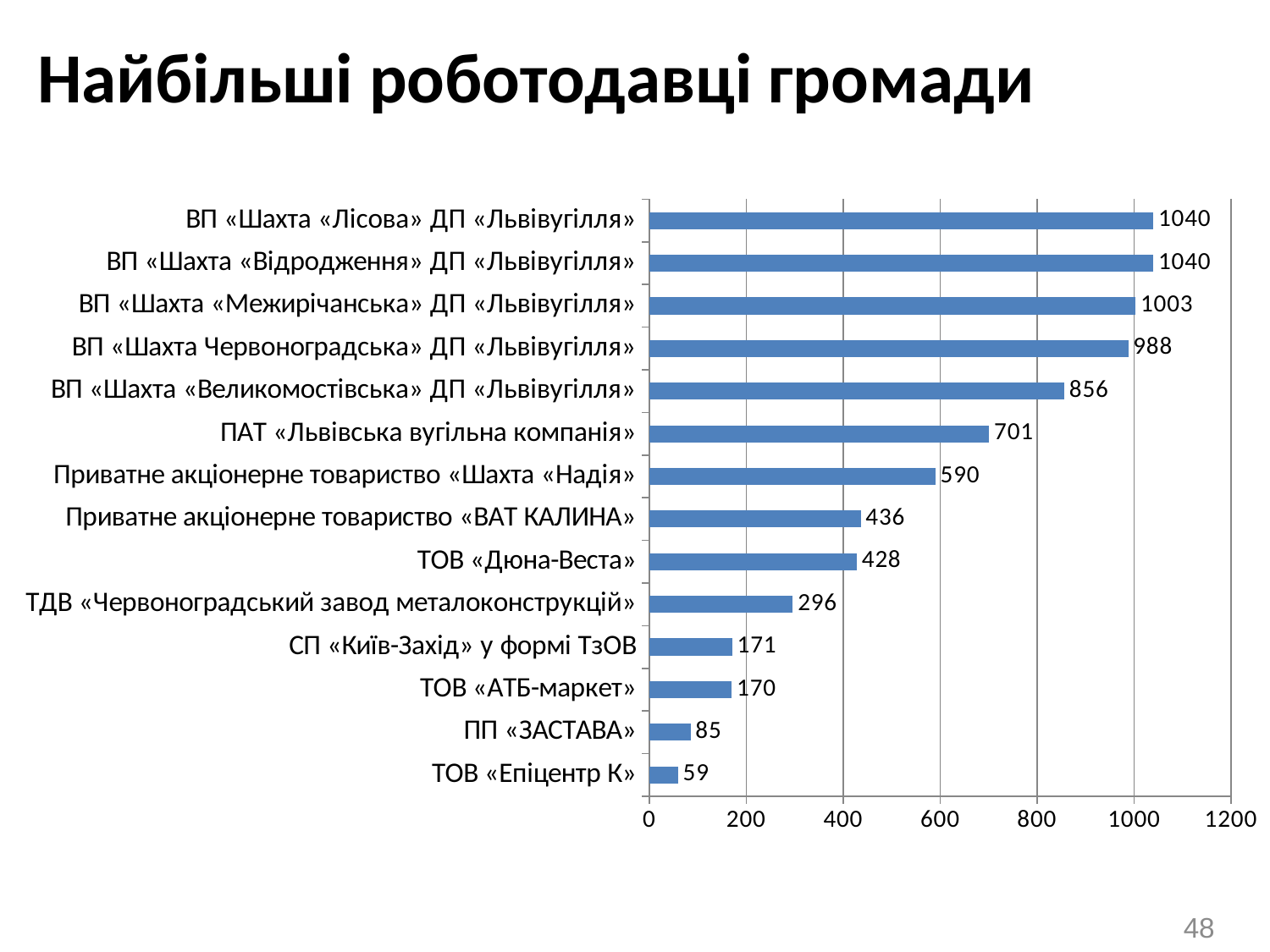
How many categories are shown in the chart? 14 What is the value for ТОВ «Дюна-Веста»? 428 What is the difference between the values for ВП «Шахта «Межирічанська» ДП «Львівугілля» and ВП «Шахта Червоноградська» ДП «Львівугілля»? 15 Which is larger, the value for ТДВ «Червоноградський завод металоконструкцій» or the value for СП «Київ-Захід» у формі ТзОВ? ТДВ «Червоноградський завод металоконструкцій» What is the title of the slide? Найбільші роботодавці громади Which category has the lowest value? ТОВ «Епіцентр К» What is the value for ПП «ЗАСТАВА»? 85 What is the difference between the values for Приватне акціонерне товариство «Шахта «Надія» and Приватне акціонерне товариство «ВАТ КАЛИНА»? 154 What is the value for ВП «Шахта «Великомостівська» ДП «Львівугілля»? 856 Is the value for ВП «Шахта «Великомостівська» ДП «Львівугілля» greater or less than 800? greater What is the value for ПАТ «Львівська вугільна компанія»? 701 What kind of chart is shown on the slide? bar chart